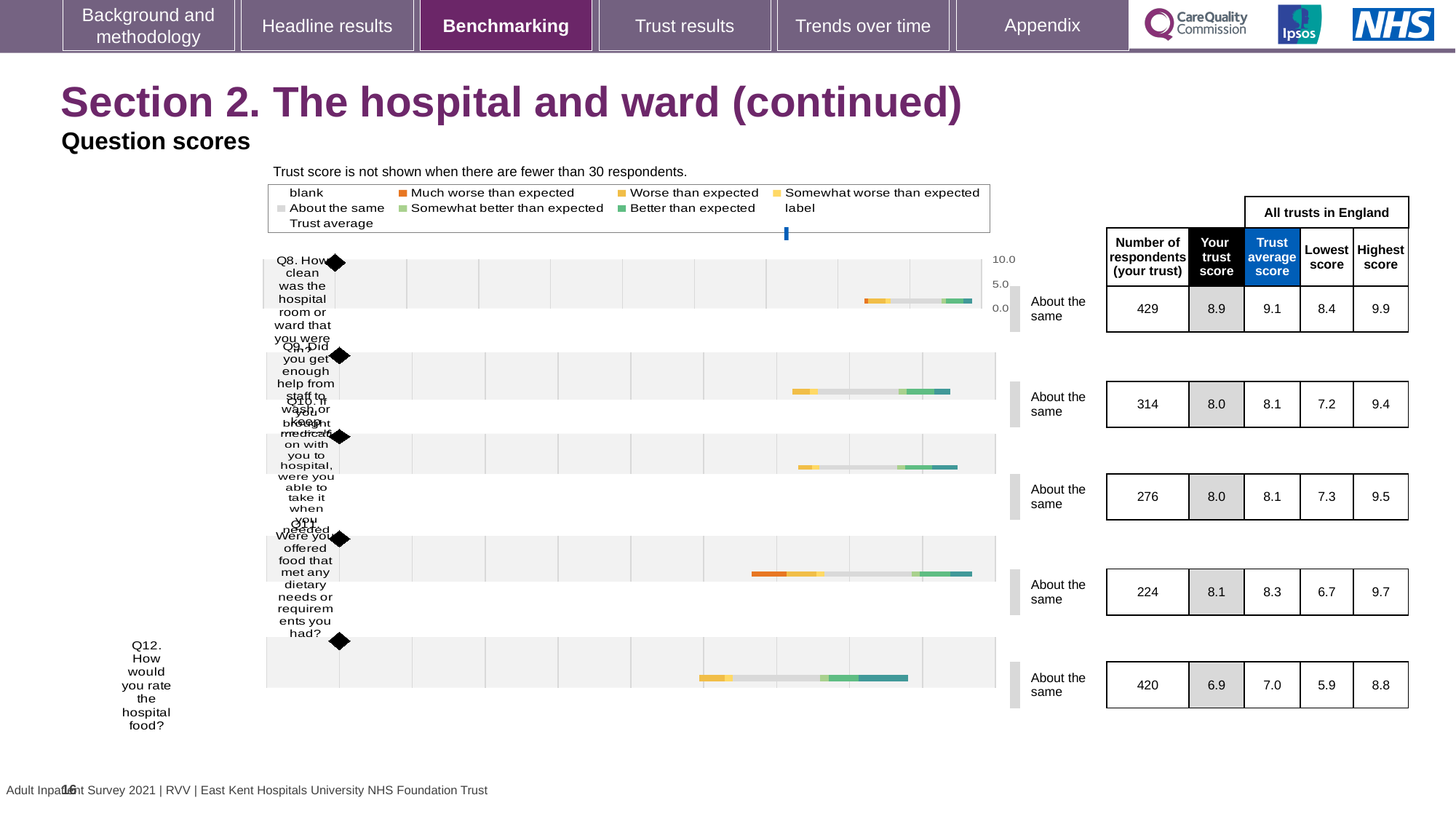
What is the 'Your trust score' for Q12 (How would you rate the hospital food?)? 6.9 How many respondents from your trust answered Q8 (How clean was the hospital room or ward)? 429 How many questions (categories) are plotted in the question scores chart? 5 For Q11, how much higher is the trust average score than your trust score? 0.2 Which question has the lowest 'Your trust score'? Q12 Is the 'Your trust score' for Q12 greater or less than 5.0? greater What benchmark category is shown for Q9 (Did you get enough help from staff to wash or keep yourself clean)? About the same Which question has the highest 'Your trust score'? Q8 What kind of chart is used to show the question scores on this slide? bar chart What is the lowest score across all trusts in England for Q11 (Were you offered food that met any dietary needs or requirements you had)? 6.7 For Q8, which is larger: your trust score or the trust average score? Trust average score For Q12, what is the difference between the highest score and the lowest score across all trusts in England? 2.9